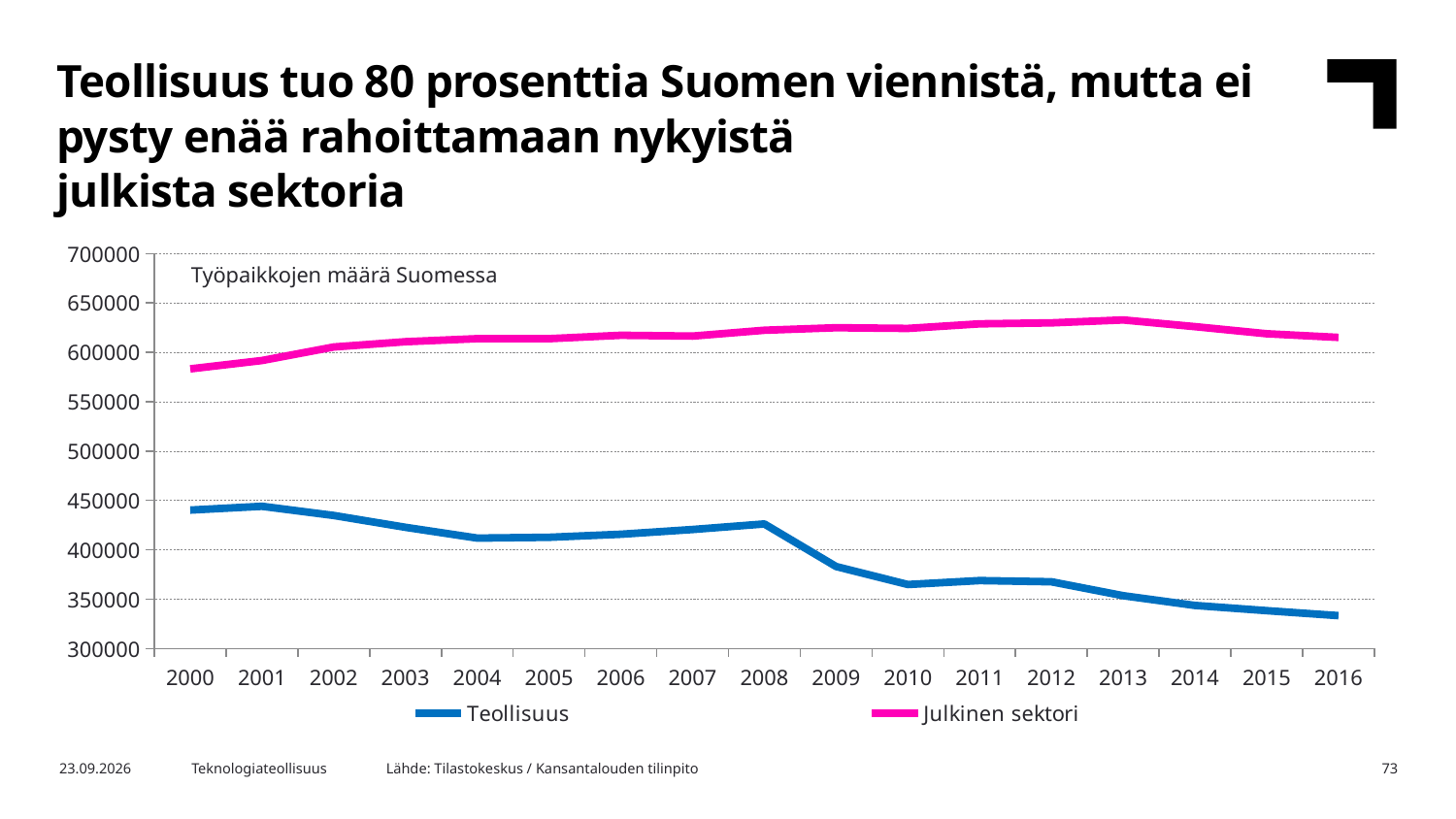
In 2016, which series has the larger value, Teollisuus or Julkinen sektori? Julkinen sektori In which year is the Julkinen sektori value lowest? 2000 In which year is the Teollisuus value lowest? 2016 How many years are plotted along the x axis? 17 Does the Teollisuus line rise or fall overall from 2000 to 2016? fall What is the title printed inside the chart area? Työpaikkojen määrä Suomessa Is the Julkinen sektori value for 2013 greater or less than 600000? greater Does the Julkinen sektori line rise or fall overall from 2000 to 2016? rise How many series does the legend list? 2 Which series is drawn in pink? Julkinen sektori Is the Teollisuus value for 2016 greater or less than 350000? less What kind of chart is shown on the slide? line chart